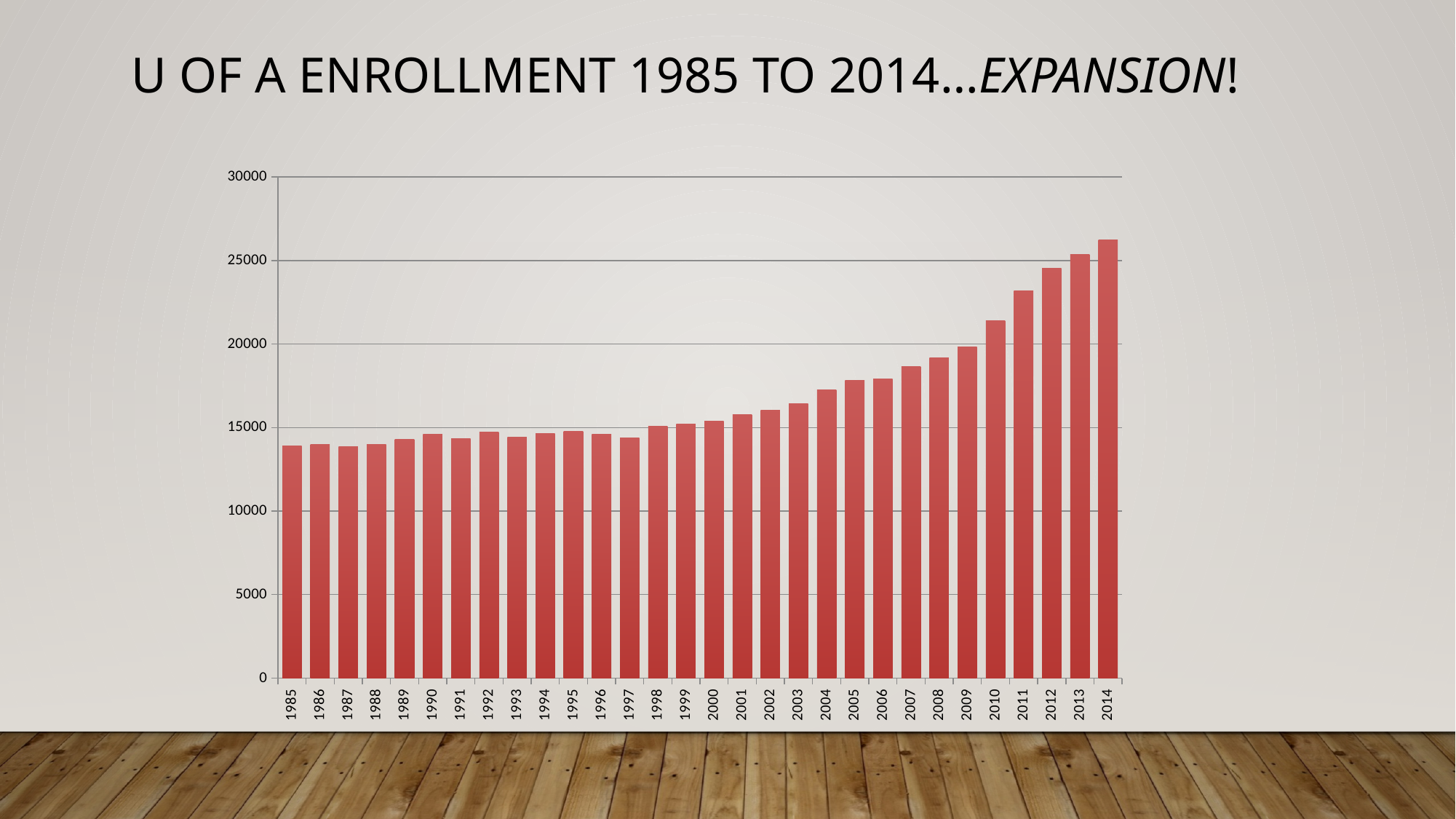
What is the title of the slide containing the chart? U of A Enrollment 1985 to 2014...Expansion! Is the value for 2014 greater or less than 25000? greater Is the value for 2011 greater or less than 20000? greater Do the enrollment values generally rise or fall from 1985 to 2014? Rise Which year has the highest enrollment on the chart? 2014 Is the value for 2010 greater or less than 20000? greater How many years (bars) are plotted on the chart? 30 What kind of chart is shown on the slide? Bar chart Which is larger, the value for 2012 or the value for 2008? 2012